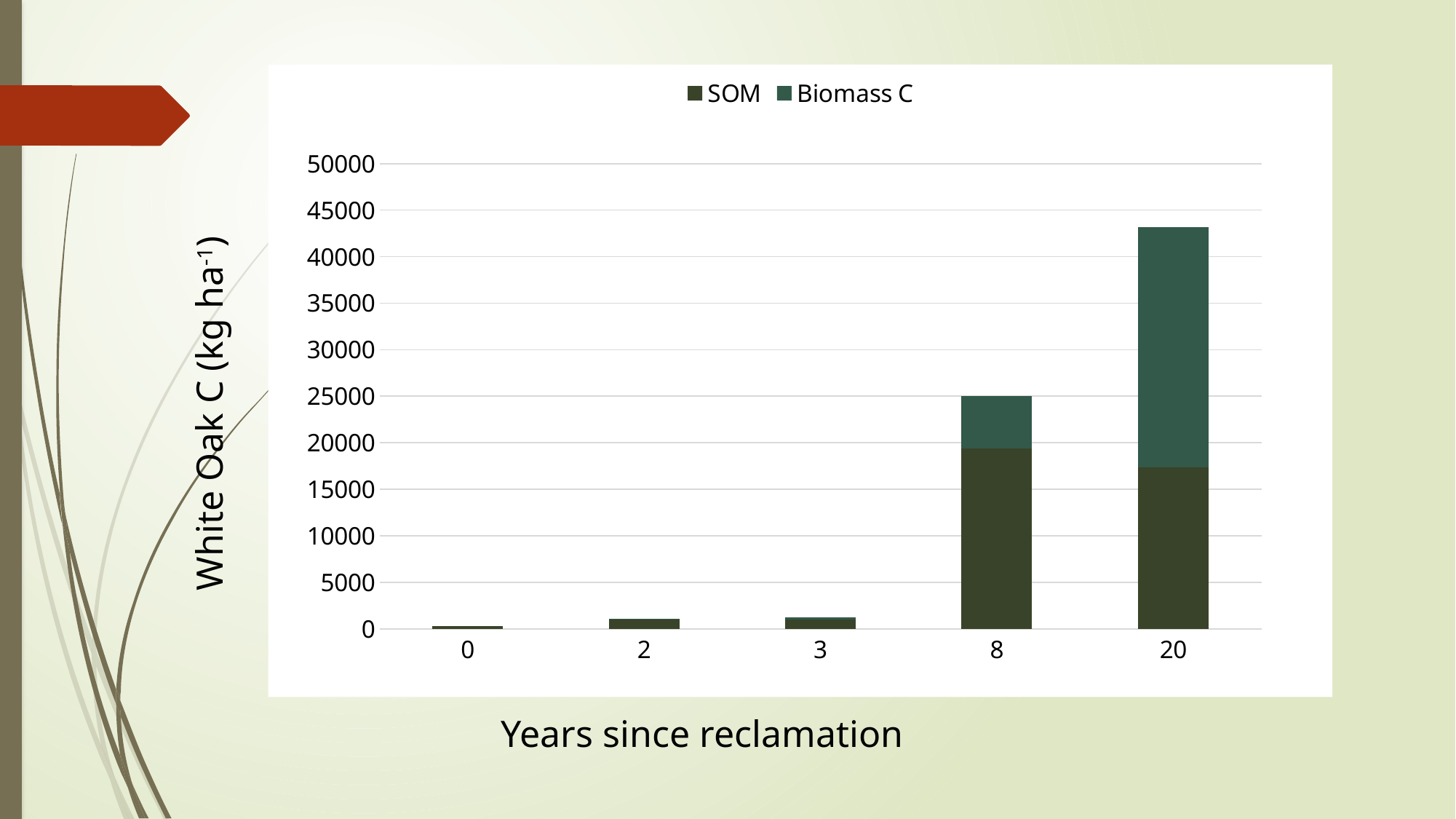
Is the SOM value at 8 years greater or less than 15000? greater How many series does the legend list? 2 Which year since reclamation has the lowest total White Oak C? 0 What is the label of the y axis? White Oak C (kg ha-1) Is the total White Oak C at 20 years greater or less than 40000? greater Do the total White Oak C values rise or fall as years since reclamation increase? rise Is the SOM value at 20 years greater or less than 20000? less How many categories (years since reclamation) are shown on the x axis? 5 Which series are listed in the legend? SOM and Biomass C Which has the larger total White Oak C, 8 years or 20 years since reclamation? 20 years What kind of chart is shown on the slide? stacked bar chart Which year since reclamation has the highest total White Oak C? 20